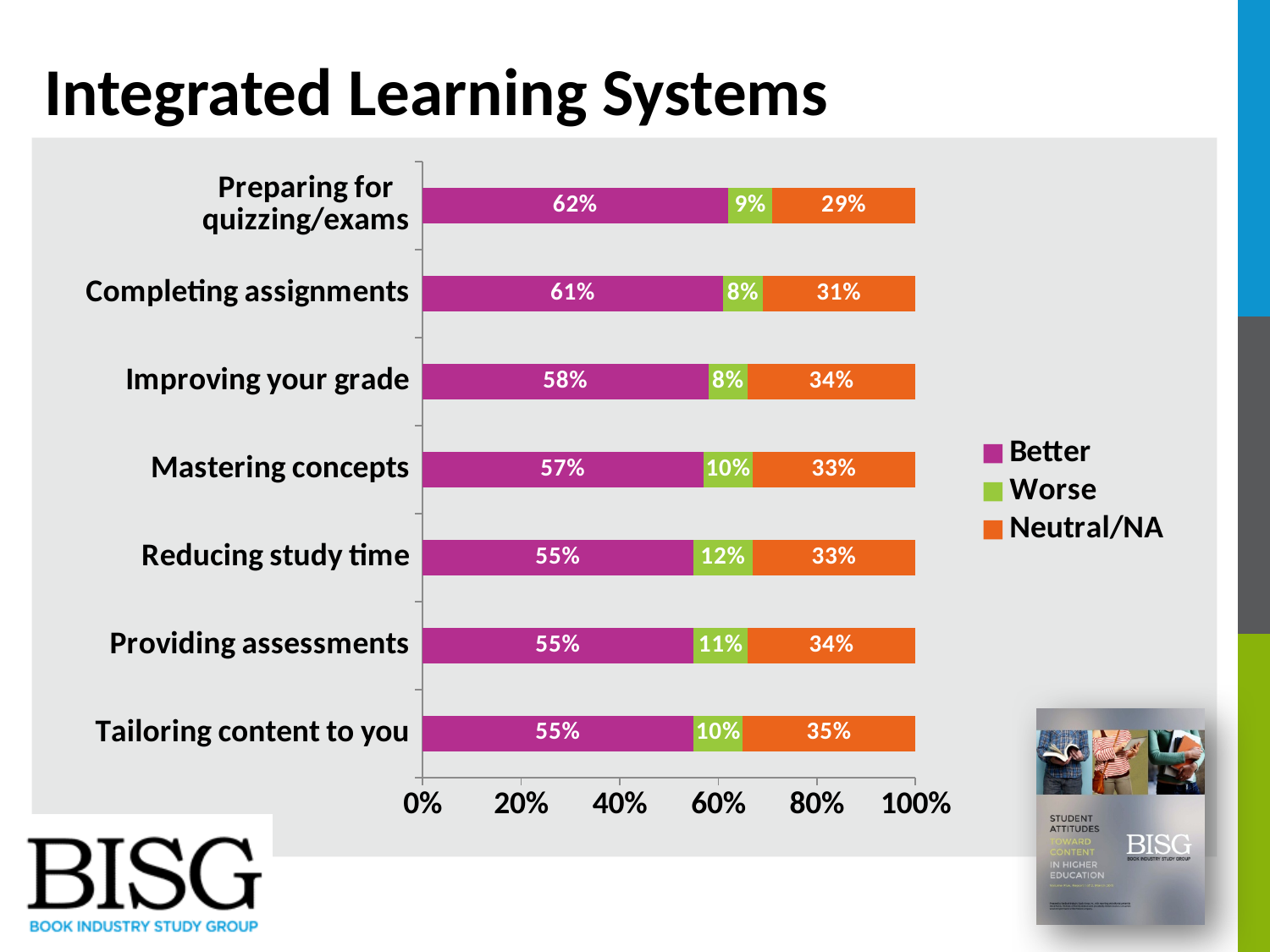
Which category has the lowest 'Neutral/NA' percentage? Preparing for quizzing/exams What is the 'Neutral/NA' value for 'Tailoring content to you'? 35% How many categories are shown on the chart? 7 What percentage of respondents said integrated learning systems made 'Preparing for quizzing/exams' better? 62% Is the 'Better' value for 'Mastering concepts' greater or less than 40%? greater Which is larger: the 'Worse' value for 'Reducing study time' or for 'Completing assignments'? Reducing study time Which category has the highest 'Better' percentage? Preparing for quizzing/exams How many series does the legend list? 3 What kind of chart is shown on the slide? Stacked bar chart What is the total of the stacked bar for 'Completing assignments'? 100% What is the 'Worse' value for 'Reducing study time'? 12% What is the difference between the 'Better' values for 'Preparing for quizzing/exams' and 'Improving your grade'? 4%